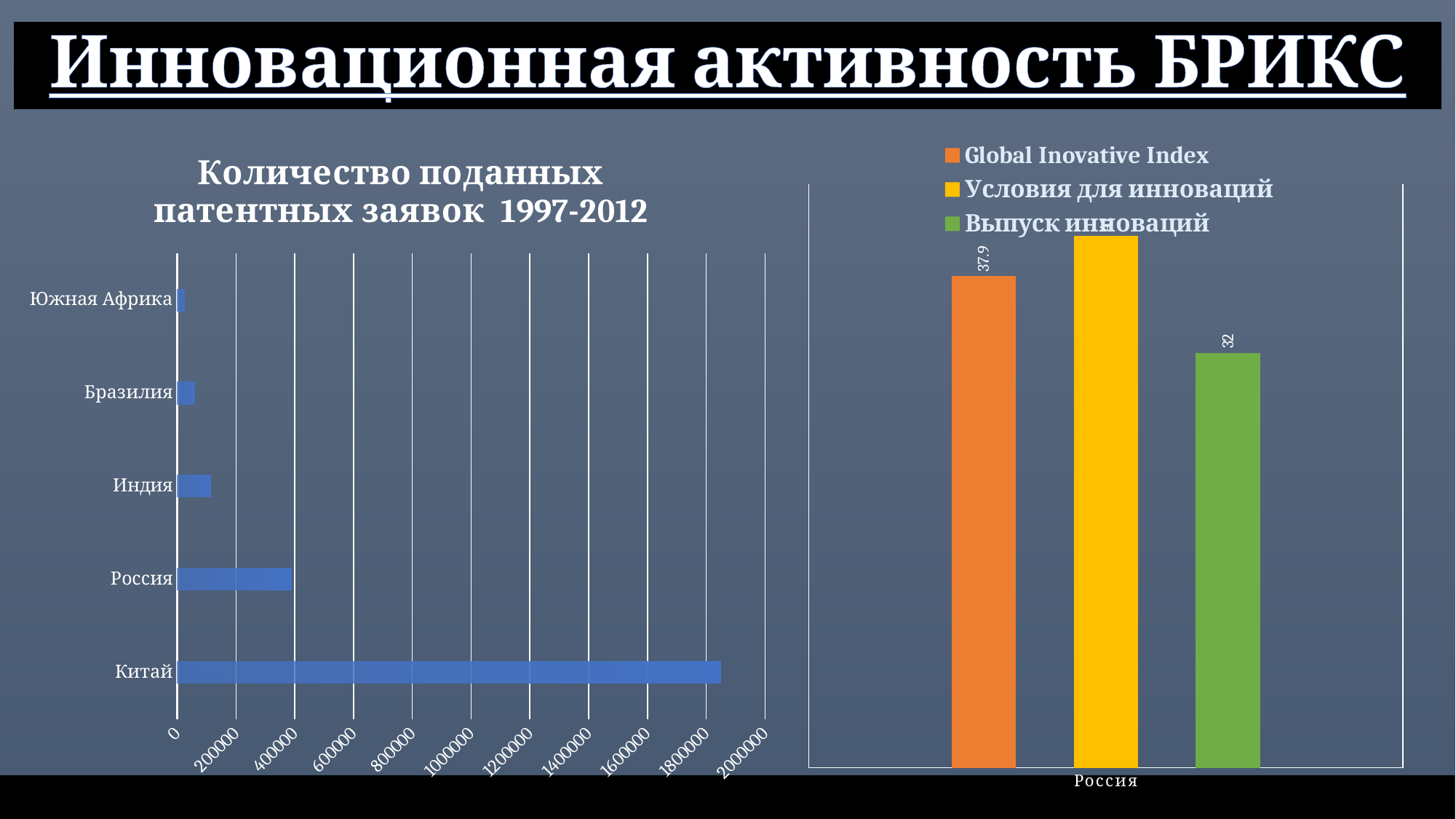
In the left chart 'Количество поданных патентных заявок 1997-2012', which country has the highest number of patent applications? Китай In the left chart 'Количество поданных патентных заявок 1997-2012', how many countries are shown? 5 In the left chart 'Количество поданных патентных заявок 1997-2012', which has more patent applications, Индия or Бразилия? Индия How many series does the legend of the right chart list? 3 In the left chart 'Количество поданных патентных заявок 1997-2012', is the value for Китай greater or less than 1800000? greater In the right chart, what is the value of Выпуск инноваций for Россия? 32 In the right chart, which series has the tallest bar for Россия? Условия для инноваций In the left chart 'Количество поданных патентных заявок 1997-2012', which country has the lowest number of patent applications? Южная Африка In the right chart, what is the value of Global Inovative Index for Россия? 37.9 What kind of chart is the left chart titled 'Количество поданных патентных заявок 1997-2012'? bar chart In the right chart, what is the difference between Global Inovative Index (37.9) and Выпуск инноваций (32) for Россия? 5.9